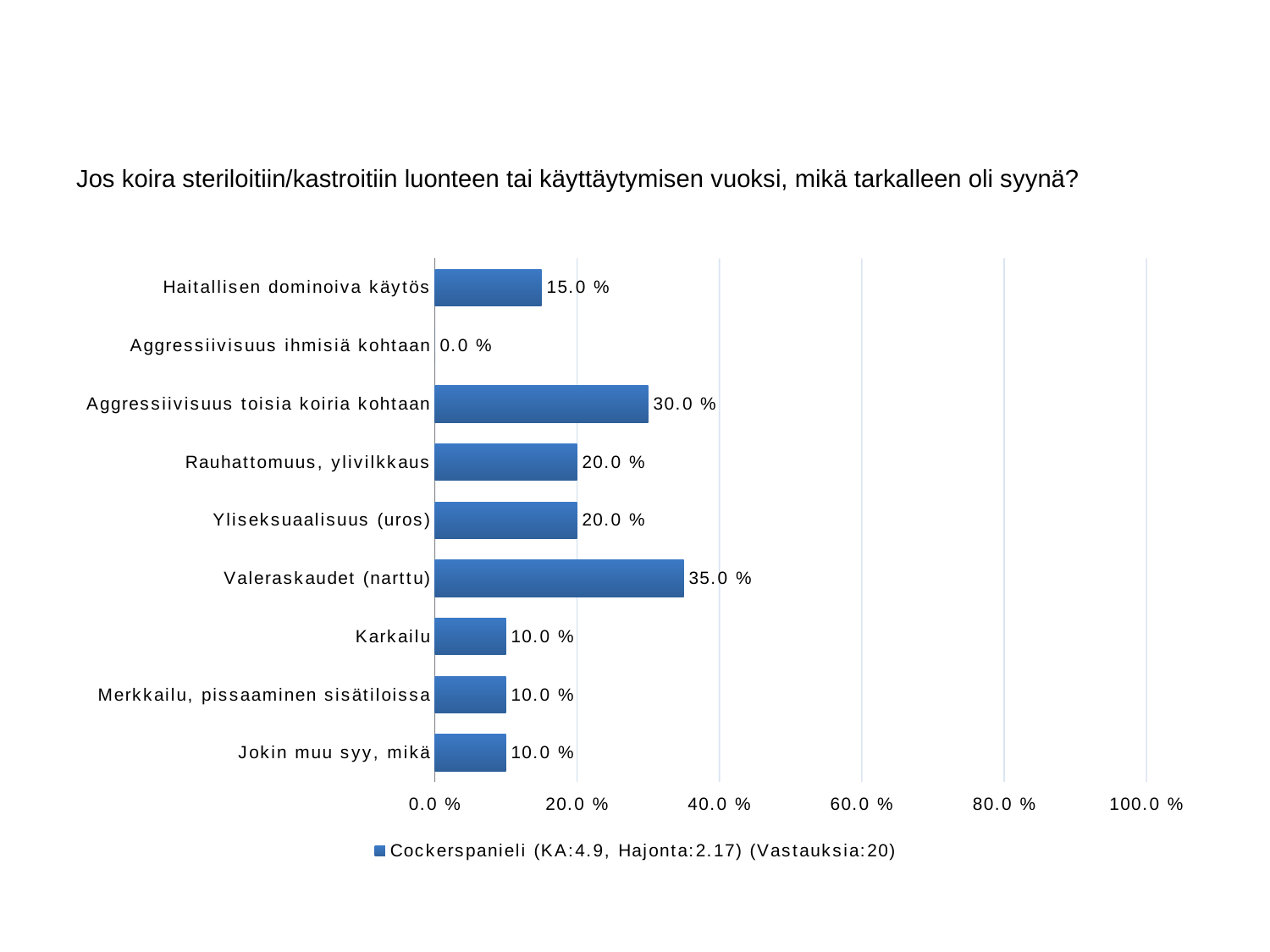
Is the value for Valeraskaudet (narttu) greater or less than 40.0 %? less Which category has the highest value? Valeraskaudet (narttu) What is the difference between the values for Valeraskaudet (narttu) and Aggressiivisuus toisia koiria kohtaan? 5.0 % What is the value for Aggressiivisuus ihmisiä kohtaan? 0.0 % Which category has the lowest value? Aggressiivisuus ihmisiä kohtaan What kind of chart is shown on the slide? bar chart What is the value for Aggressiivisuus toisia koiria kohtaan? 30.0 % How many categories are shown in the chart? 9 Which is larger, the value for Rauhattomuus, ylivilkkaus or the value for Karkailu? Rauhattomuus, ylivilkkaus What series does the legend list? Cockerspanieli (KA:4.9, Hajonta:2.17) (Vastauksia:20) What is the value for Valeraskaudet (narttu)? 35.0 % What is the value for Haitallisen dominoiva käytös? 15.0 %